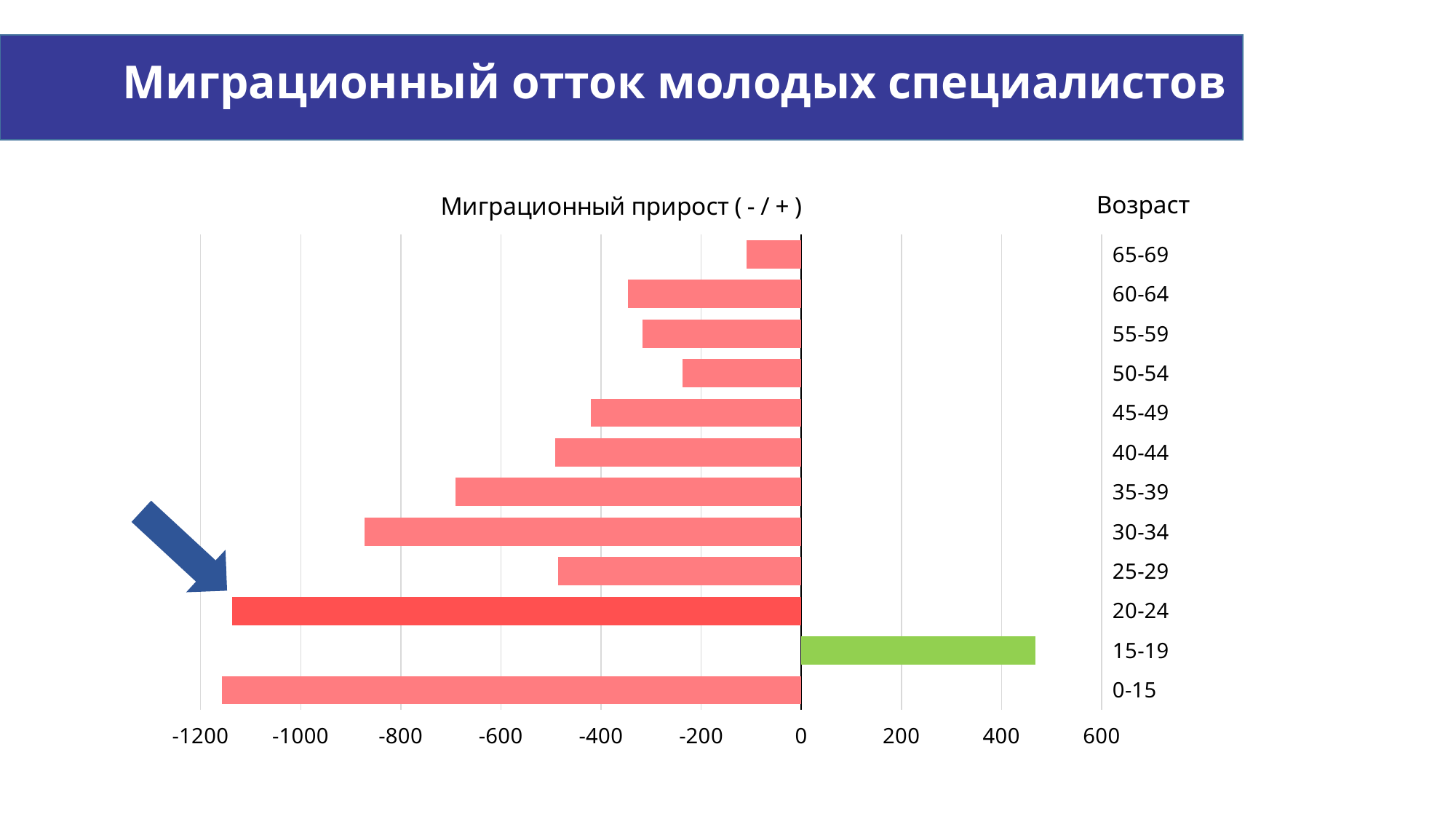
Is the value for the 35-39 age group greater or less than -600? less Is the value for the 30-34 age group greater or less than -800? less What is the title of the slide? Миграционный отток молодых специалистов Is the value for the 15-19 age group greater or less than 400? greater Which age group has the larger (less negative) value: 45-49 or 50-54? 50-54 Which age group has the highest (only positive) migration growth value? 15-19 How many age groups are plotted on the chart? 12 What colour is the bar for the 15-19 age group? green Which age group has the bar closest to zero? 65-69 What kind of chart is shown on the slide? bar chart